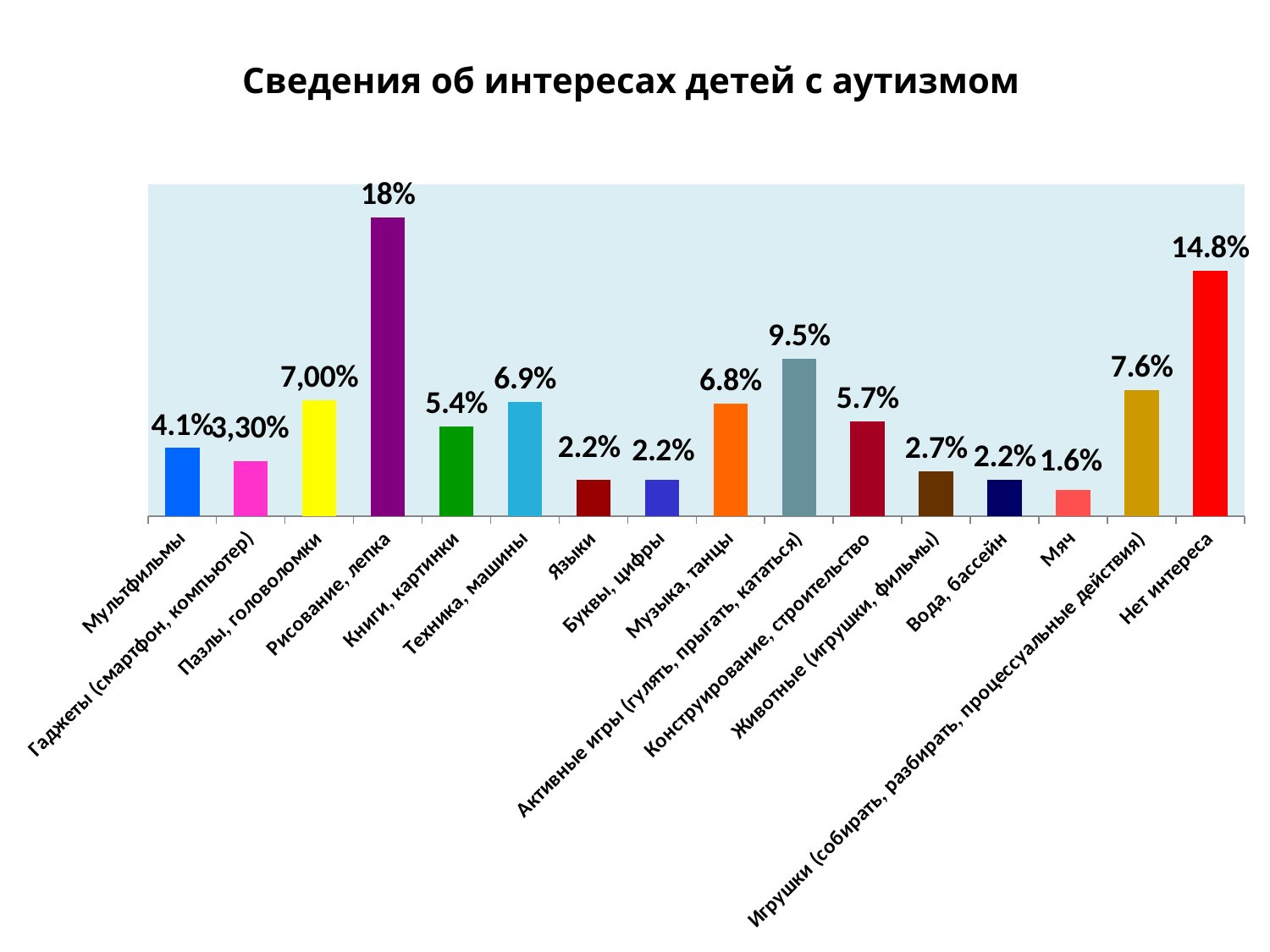
What is the difference between the values for Рисование, лепка and Нет интереса? 3.2% Which is larger, the value for Пазлы, головоломки or the value for Книги, картинки? Пазлы, головоломки What kind of chart is shown on the slide? Bar chart Which category has the highest value? Рисование, лепка What is the value for Рисование, лепка? 18% What is the value for Животные (игрушки, фильмы)? 2.7% Which category has the lowest value? Мяч What is the value for Активные игры (гулять, прыгать, кататься)? 9.5% What is the value for Гаджеты (смартфон, компьютер)? 3,30% What is the title of the chart? Сведения об интересах детей с аутизмом What is the value for Нет интереса? 14.8% How many categories are plotted in the chart? 16